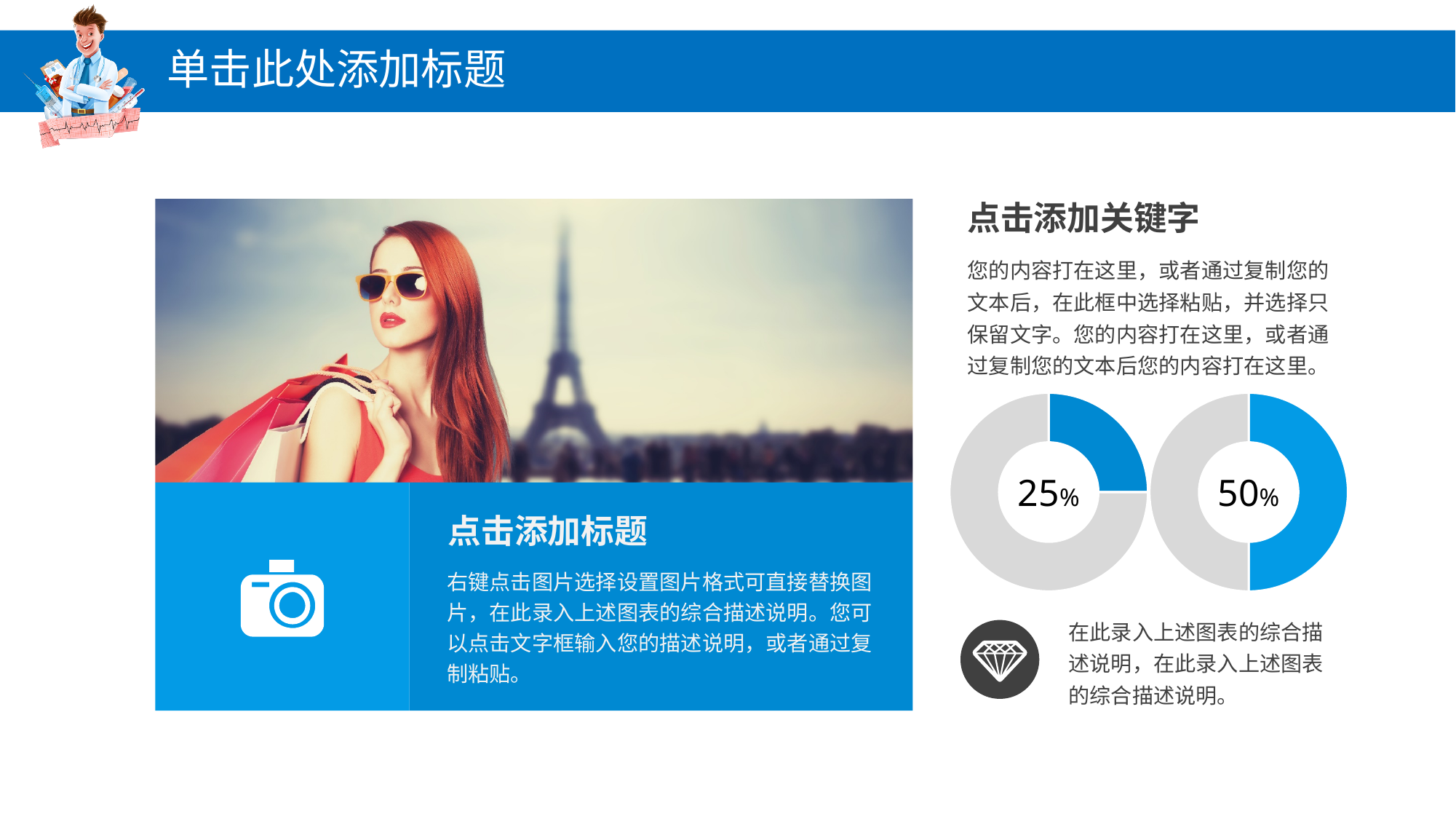
In the left donut chart, what share of the ring is filled in blue? 25% What colour is the unfilled remainder of each donut ring? grey What value is shown in the centre of the right donut chart? 50% What kind of chart is used to display the 25% and 50% values? donut chart How many donut charts are shown on the slide? 2 In the right donut chart, what share of the ring is filled in blue? 50% What is the difference between the percentage in the right donut chart and the percentage in the left donut chart? 25% What colour is used for the filled portion of each donut chart? blue Is the value shown in the left donut chart greater or less than 50%? less What value is shown in the centre of the left donut chart? 25% Which donut chart shows the larger percentage, the left one or the right one? the right one